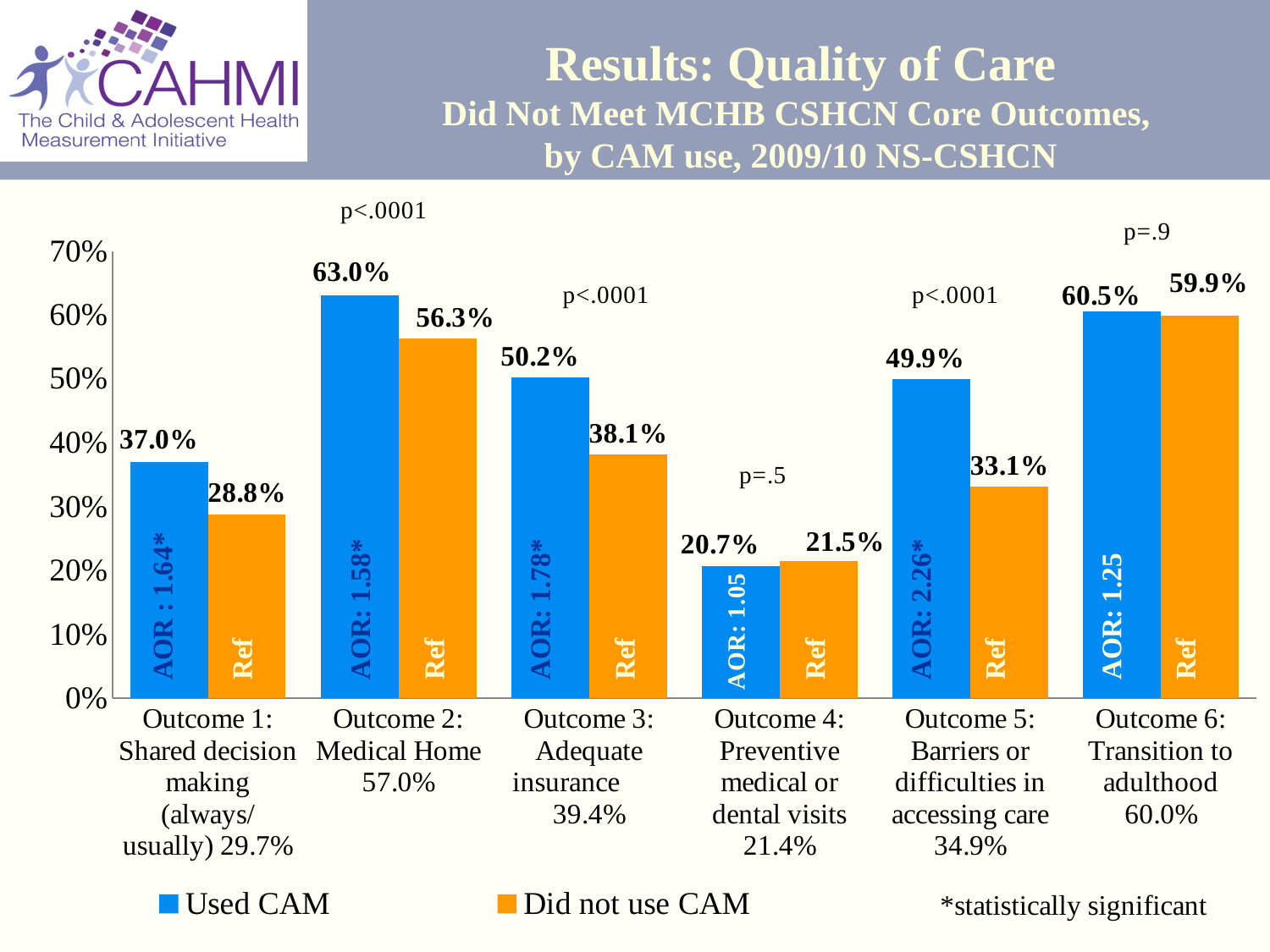
What is the difference between the Used CAM and Did not use CAM values for Outcome 5: Barriers or difficulties in accessing care? 16.8% What is the value for Used CAM for Outcome 2: Medical Home? 63.0% Which outcome has the highest value for Did not use CAM? Outcome 6: Transition to adulthood For Outcome 4: Preventive medical or dental visits, which is larger: Used CAM or Did not use CAM? Did not use CAM Which outcome has the lowest value for Used CAM? Outcome 4: Preventive medical or dental visits How many series does the legend list? 2 Is the value for Used CAM for Outcome 1: Shared decision making greater or less than 40%? less What is the value for Used CAM for Outcome 5: Barriers or difficulties in accessing care? 49.9% What kind of chart is shown on the slide? bar chart What is the value for Did not use CAM for Outcome 3: Adequate insurance? 38.1% What AOR is printed on the Used CAM bar for Outcome 5? AOR: 2.26* How many outcome categories are shown on the x axis? 6